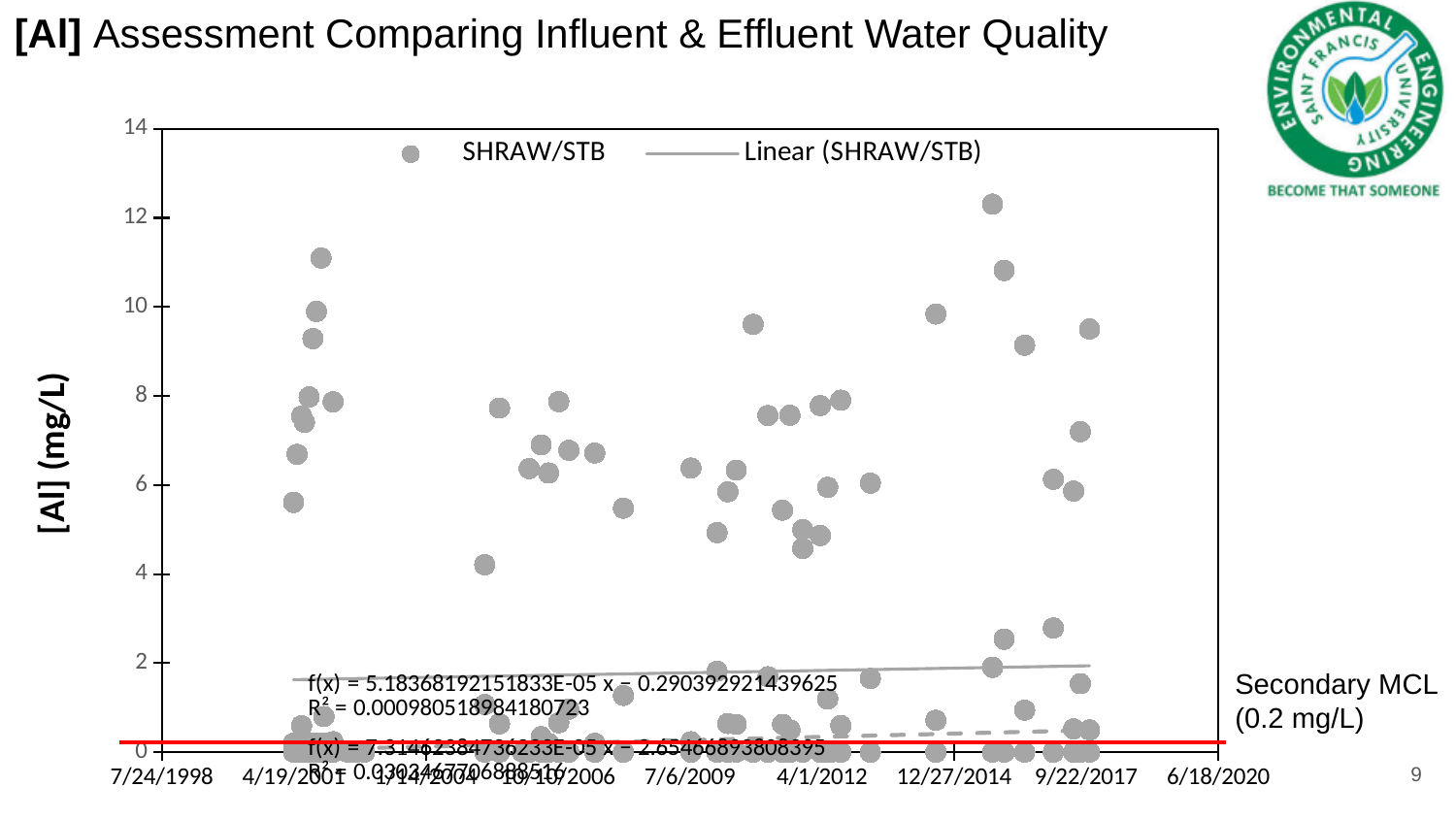
Does the Linear (SHRAW/STB) trendline rise or fall from left to right? rises What is the highest tick value shown on the y axis? 14 What is the slope coefficient in the printed trendline equation f(x) = 5.18368192151833E-05 x − 0.290392921439625? 5.18368192151833E-05 How many entries does the chart legend list? 2 What Secondary MCL value is labelled next to the red line on the chart? 0.2 mg/L Is the highest plotted point near 4/19/2001 greater or less than 10? greater Is the highest plotted SHRAW/STB value greater or less than 12? greater What is the title of the chart's y axis? [Al] (mg/L) What R² value is printed for the trendline equation f(x) = 5.18368192151833E-05 x − 0.290392921439625? 0.000980518984180723 What kind of chart is shown on the slide? Scatter chart